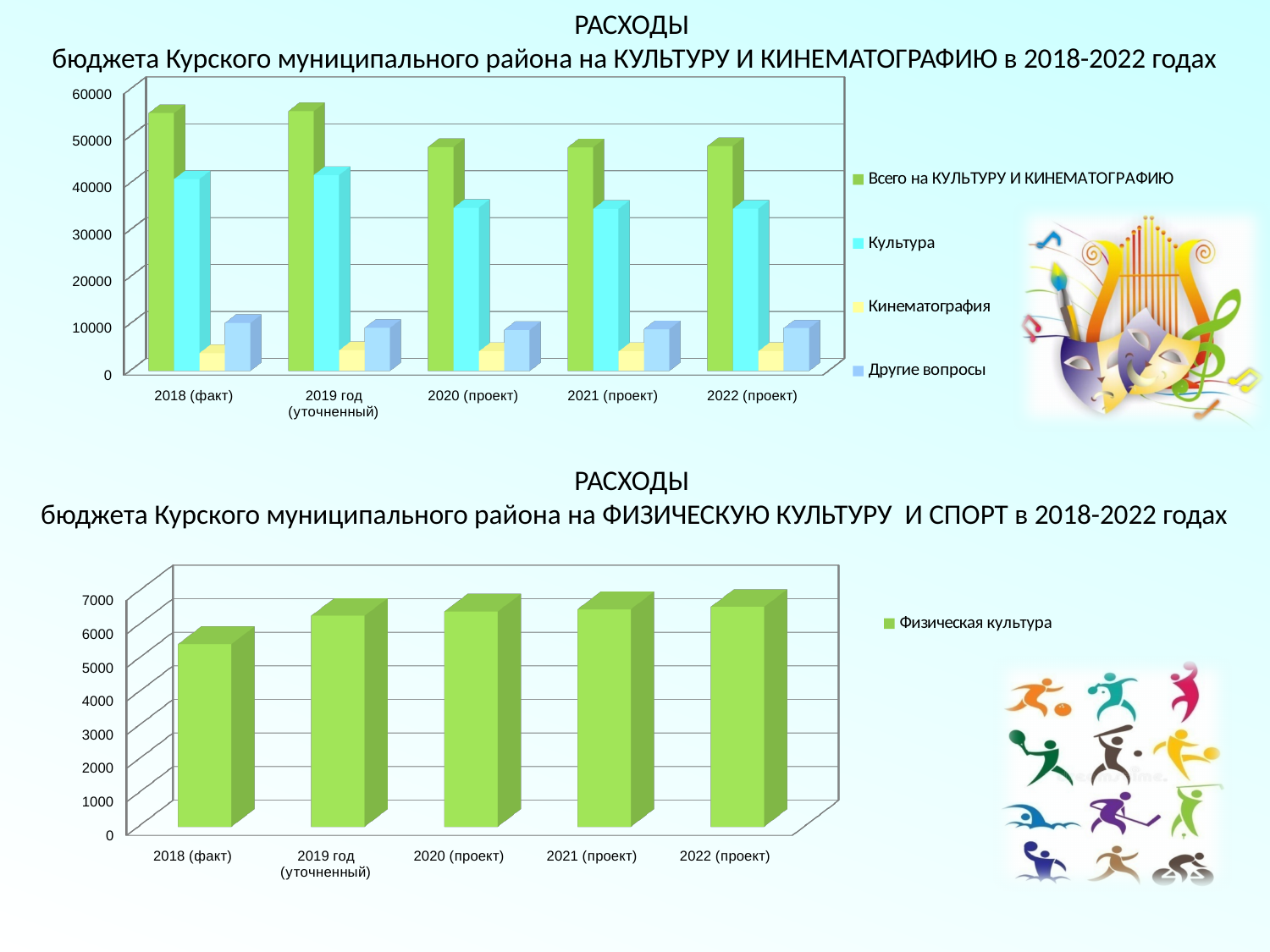
In the top chart (culture and cinematography), which series has the lowest value for 2018 (факт)? Кинематография How many year categories are shown on the x axis of the top chart (culture and cinematography)? 5 In the bottom chart (physical culture and sport), is the value for 2022 (проект) greater or less than 7000? less In the bottom chart (physical culture and sport), which year has the lowest value? 2018 (факт) What type of chart is the top chart on the slide (expenses on culture and cinematography)? bar chart How many series does the legend of the top chart (culture and cinematography) list? 4 In the top chart (culture and cinematography), is the value of 'Всего на КУЛЬТУРУ И КИНЕМАТОГРАФИЮ' for 2018 (факт) greater or less than 50000? greater In the top chart (culture and cinematography), which is larger for 'Всего на КУЛЬТУРУ И КИНЕМАТОГРАФИЮ': 2018 (факт) or 2020 (проект)? 2018 (факт) What is the name of the only series in the legend of the bottom chart (physical culture and sport)? Физическая культура In the top chart (culture and cinematography), is the value of 'Кинематография' for 2018 (факт) greater or less than 10000? less In the bottom chart (physical culture and sport), do the values generally rise or fall from 2018 to 2022? rise